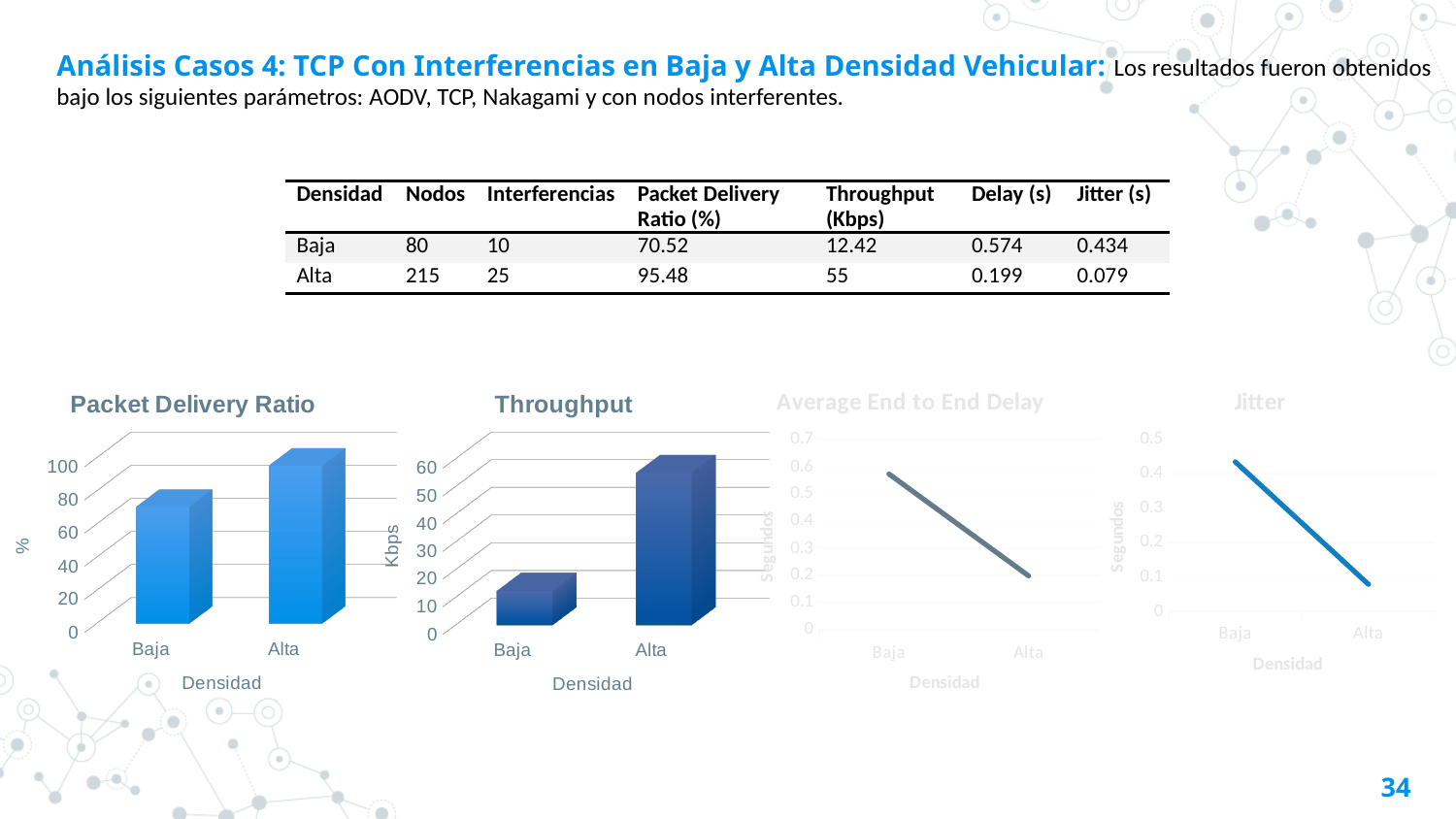
In the Average End to End Delay chart, does the value rise or fall from Baja to Alta? fall In the Average End to End Delay chart, is the value for Baja greater or less than 0.5? greater How many categories are shown on the x axis of the Throughput chart? 2 In the Jitter chart, does the value rise or fall from Baja to Alta? fall In the Packet Delivery Ratio chart, is the value for Baja greater or less than 80? less What kind of chart is the Average End to End Delay chart? line chart What is the x-axis title of the Packet Delivery Ratio chart? Densidad What is the y-axis label of the Throughput chart? Kbps What kind of chart is the Packet Delivery Ratio chart? bar chart In the Packet Delivery Ratio chart, which category has the higher value, Baja or Alta? Alta In the Throughput chart, is the value for Baja greater or less than 20? less